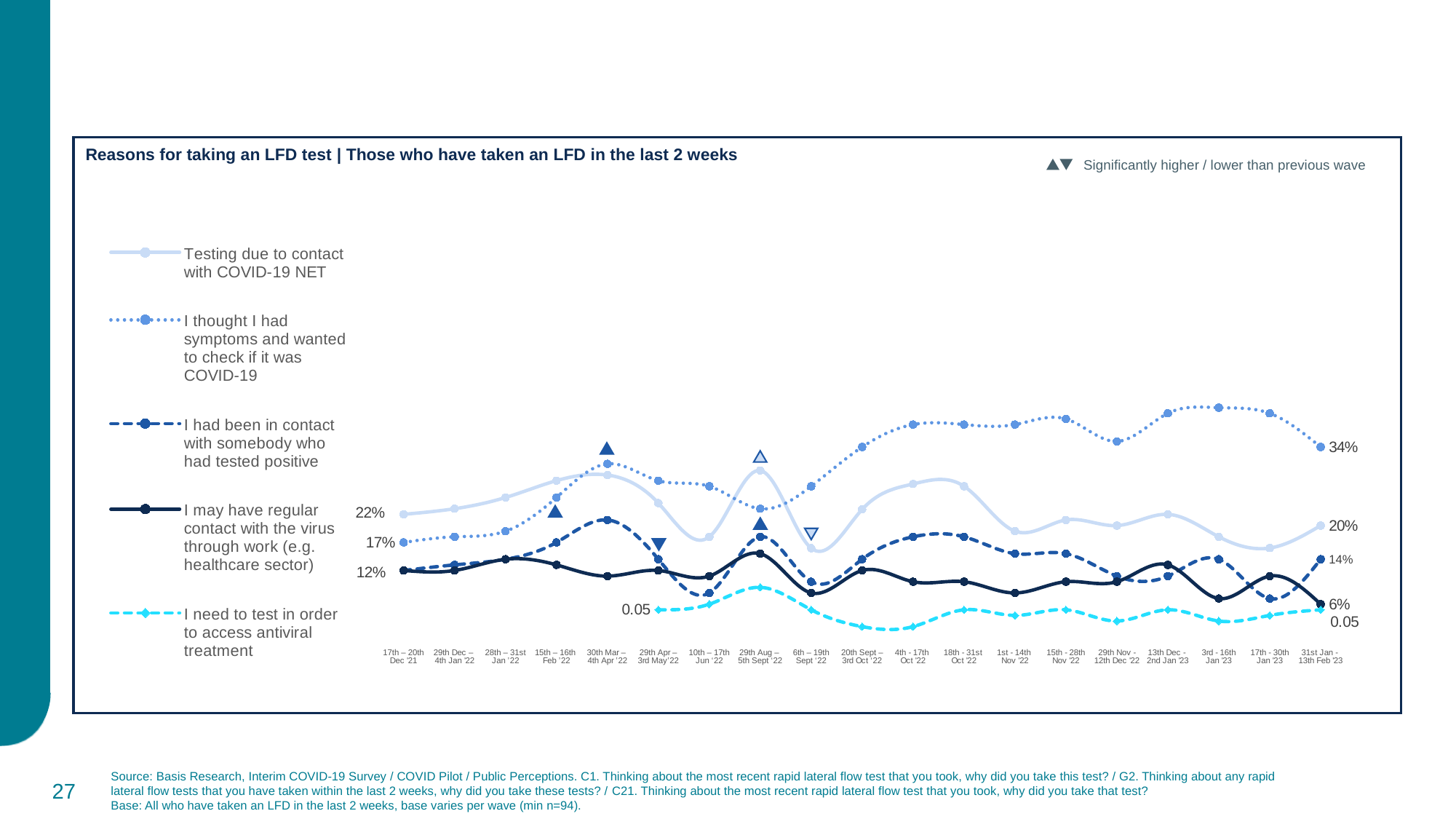
What is the value for 'I had been in contact with somebody who had tested positive' in the 31st Jan - 13th Feb '23 wave? 14% Does the 'I thought I had symptoms and wanted to check if it was COVID-19' line rise or fall overall from the first wave to the last wave? Rise How many survey waves are shown along the x axis? 19 What is the value for 'I thought I had symptoms and wanted to check if it was COVID-19' in the 31st Jan - 13th Feb '23 wave? 34% Which reason has the highest value in the 31st Jan - 13th Feb '23 wave? I thought I had symptoms and wanted to check if it was COVID-19 What is the value for 'I may have regular contact with the virus through work' in the 31st Jan - 13th Feb '23 wave? 6% What kind of chart is shown on the slide? Line chart What is the value for 'Testing due to contact with COVID-19 NET' in the 31st Jan - 13th Feb '23 wave? 20% In the 31st Jan - 13th Feb '23 wave, what is the difference between 'I thought I had symptoms' (34%) and 'Testing due to contact with COVID-19 NET' (20%)? 14 percentage points What is the value for 'I thought I had symptoms and wanted to check if it was COVID-19' in the 17th – 20th Dec '21 wave? 17% What is the value for 'Testing due to contact with COVID-19 NET' in the 17th – 20th Dec '21 wave? 22% How many series does the legend list? 5